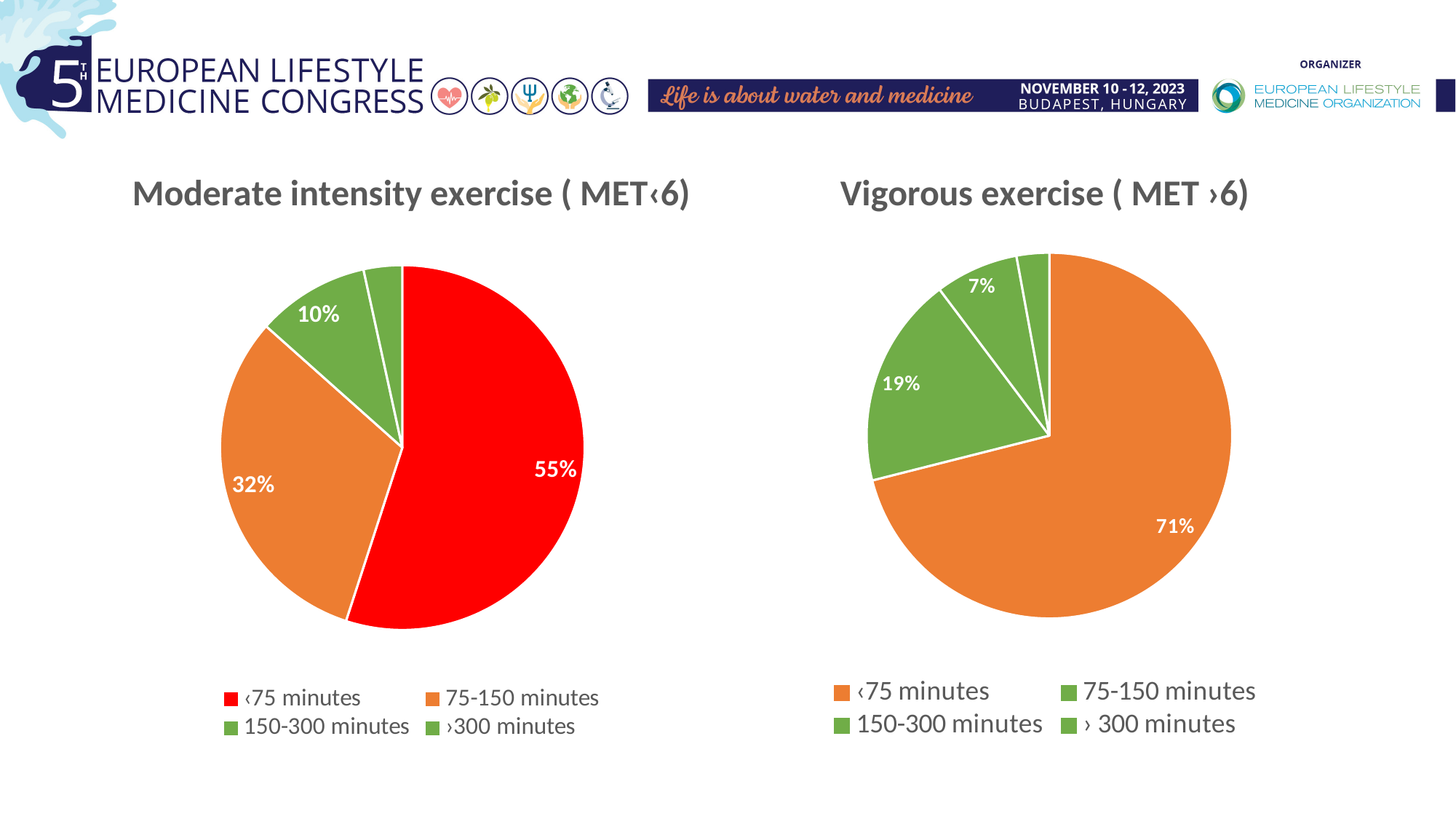
In the Vigorous exercise (MET>6) chart, which category has the largest slice? <75 minutes What is the difference between the <75 minutes share in the Vigorous exercise chart and the <75 minutes share in the Moderate intensity exercise chart? 16% In the Vigorous exercise (MET>6) chart, what share of the pie is the <75 minutes slice? 71% In the Moderate intensity exercise (MET<6) chart, what percentage is shown for 75-150 minutes? 32% In the Moderate intensity exercise (MET<6) chart, what percentage is shown for 150-300 minutes? 10% In the Moderate intensity exercise (MET<6) chart, which is larger: the 75-150 minutes slice or the 150-300 minutes slice? 75-150 minutes In the Vigorous exercise (MET>6) chart, what percentage is shown for 75-150 minutes? 19% In the Moderate intensity exercise (MET<6) chart, which category has the smallest slice? >300 minutes What type of chart is used for Moderate intensity exercise (MET<6)? Pie chart In the Vigorous exercise (MET>6) chart, what percentage is shown for 150-300 minutes? 7% How many categories does the legend of the Vigorous exercise (MET>6) chart list? 4 In the Moderate intensity exercise (MET<6) chart, what share of the pie is the <75 minutes slice? 55%